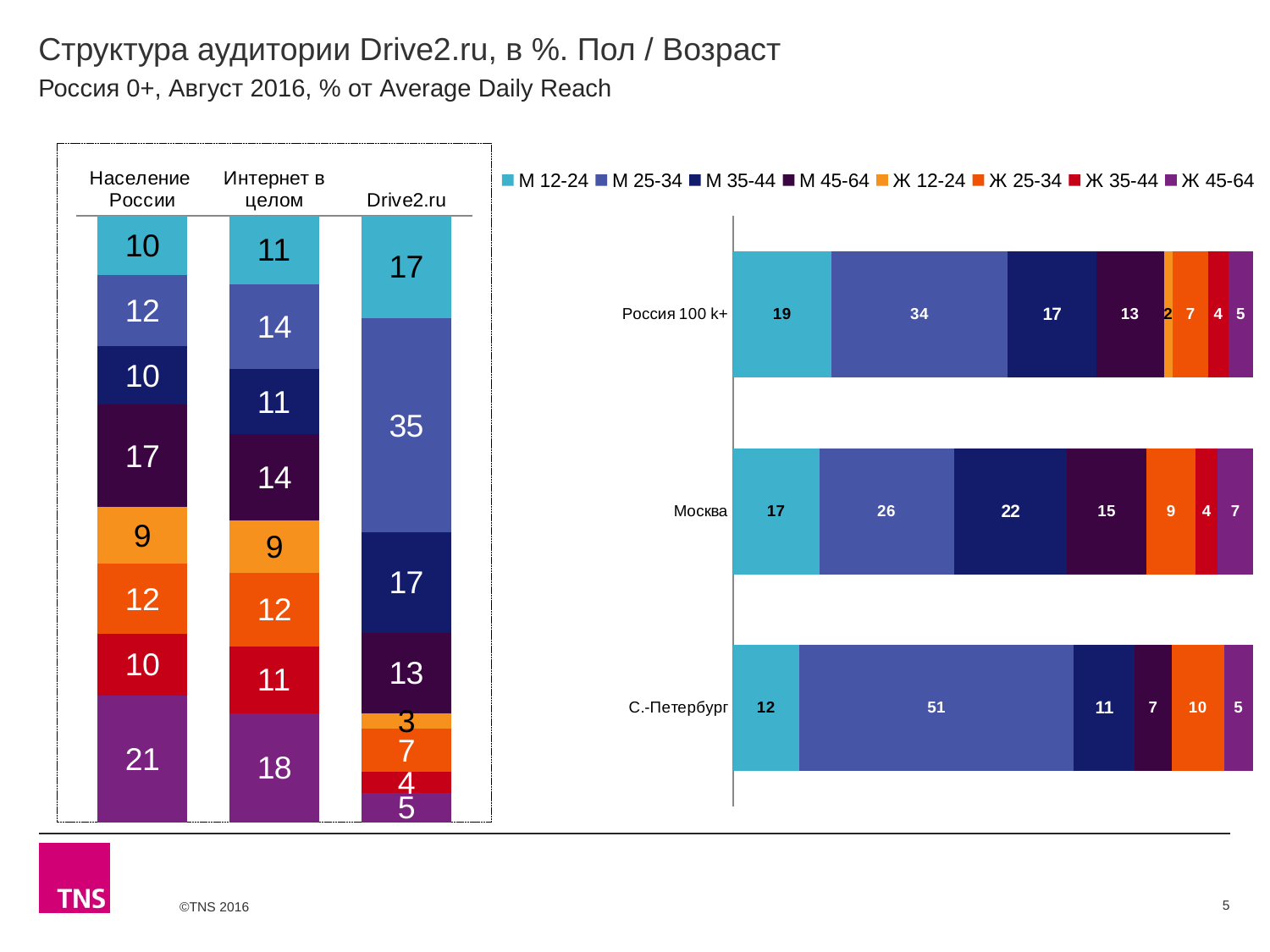
How many series does the legend list? 8 In the right chart, what is the value for Ж 12-24 in Россия 100 k+? 2 In the left chart, which segment of the Drive2.ru bar has the smallest value? Ж 12-24 In the right chart, what is the value for М 35-44 in Москва? 22 How many categories are shown in the right chart? 3 In the right chart, which category has the highest value for М 25-34? С.-Петербург In the left chart, what is the value of the М 25-34 segment for Drive2.ru? 35 In the left chart, what is the value of the Ж 45-64 segment for Население России? 21 In the left chart, which is larger: the М 12-24 segment for Drive2.ru or for Интернет в целом? Drive2.ru In the right chart, what is the value for М 25-34 in С.-Петербург? 51 In the left chart, what is the total of the Интернет в целом bar? 100 In the right chart, what is the difference between the М 25-34 values for С.-Петербург and Москва? 25